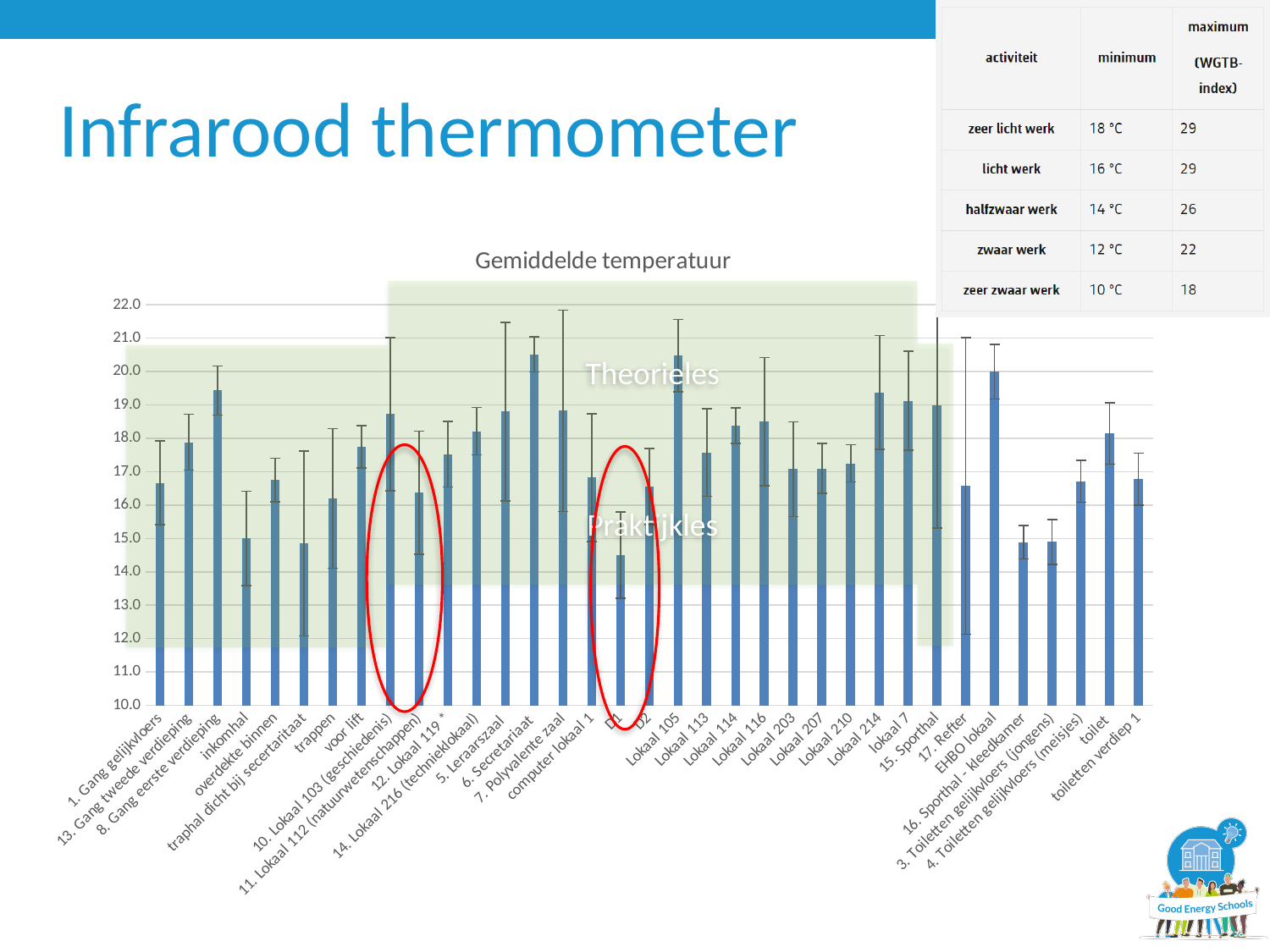
Is the value for 6. Secretariaat greater or less than 20.0? greater Which has the higher value, D1 or D2? D2 What are the lowest and highest values shown on the vertical axis of the chart? 10.0 and 22.0 Which has the higher value, 8. Gang eerste verdieping or inkomhal? 8. Gang eerste verdieping What kind of chart is shown on the slide? bar chart Which has the higher value, Lokaal 105 or Lokaal 113? Lokaal 105 Is the value for trappen greater or less than 15.0? greater Is the value for inkomhal greater or less than 16.0? less What is the title of the chart? Gemiddelde temperatuur